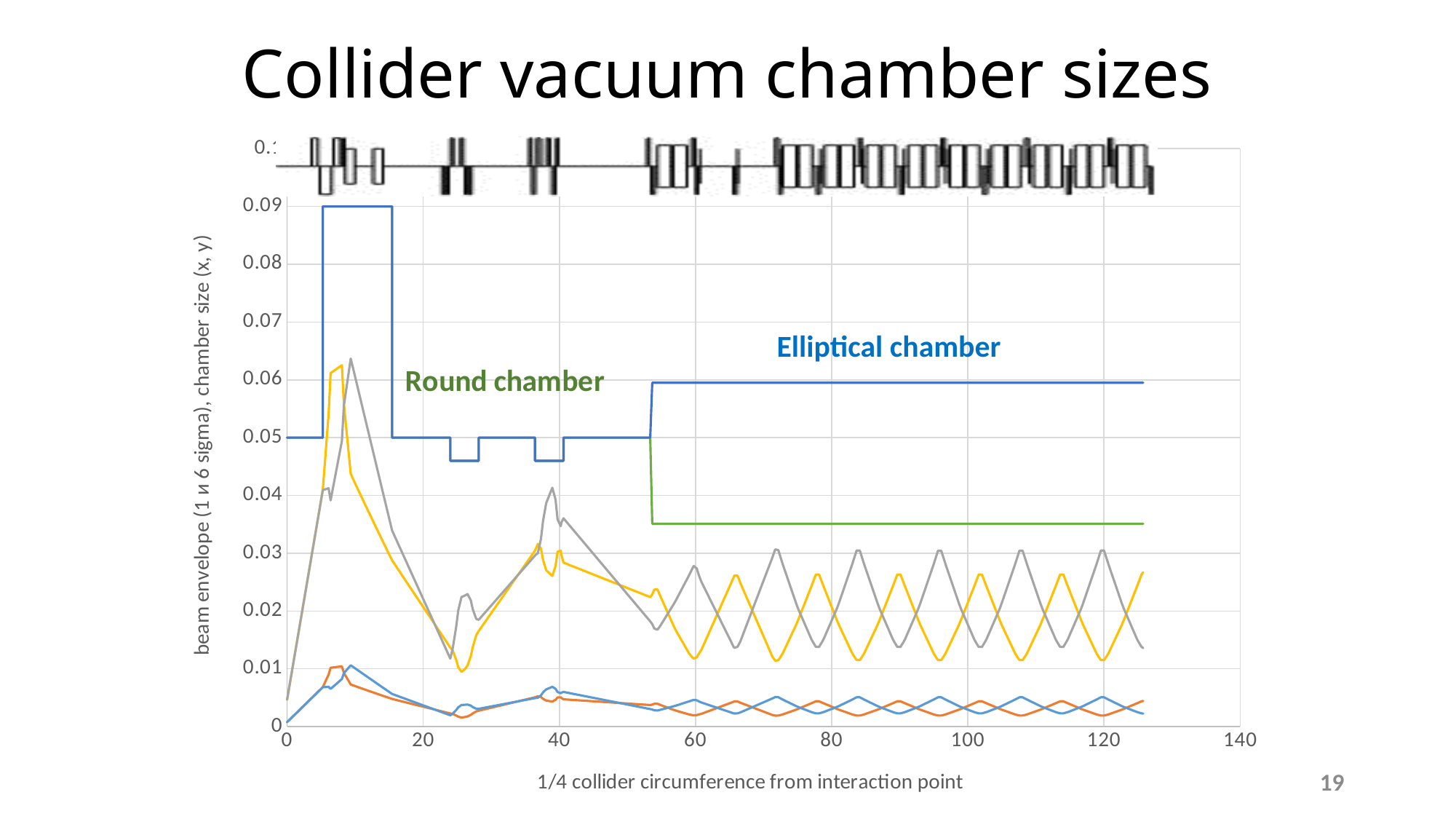
What is the value of the blue Elliptical chamber line at x = 0? 0.05 At x = 100, which line is higher: the blue Elliptical chamber line or the green Round chamber line? blue Elliptical chamber line Does the blue Elliptical chamber line rise, fall or stay flat between x = 60 and x = 120? stays flat What is the highest value reached by the blue Elliptical chamber line? 0.09 Is the value of the green Round chamber line at x = 100 greater or less than 0.04? less Is the orange line at x = 120 greater or less than 0.02? less Is the peak value of the grey line greater or less than 0.07? less What kind of chart is shown on the slide? line chart What is the title of the slide's chart? Collider vacuum chamber sizes Which colour line is labelled "Round chamber"? green